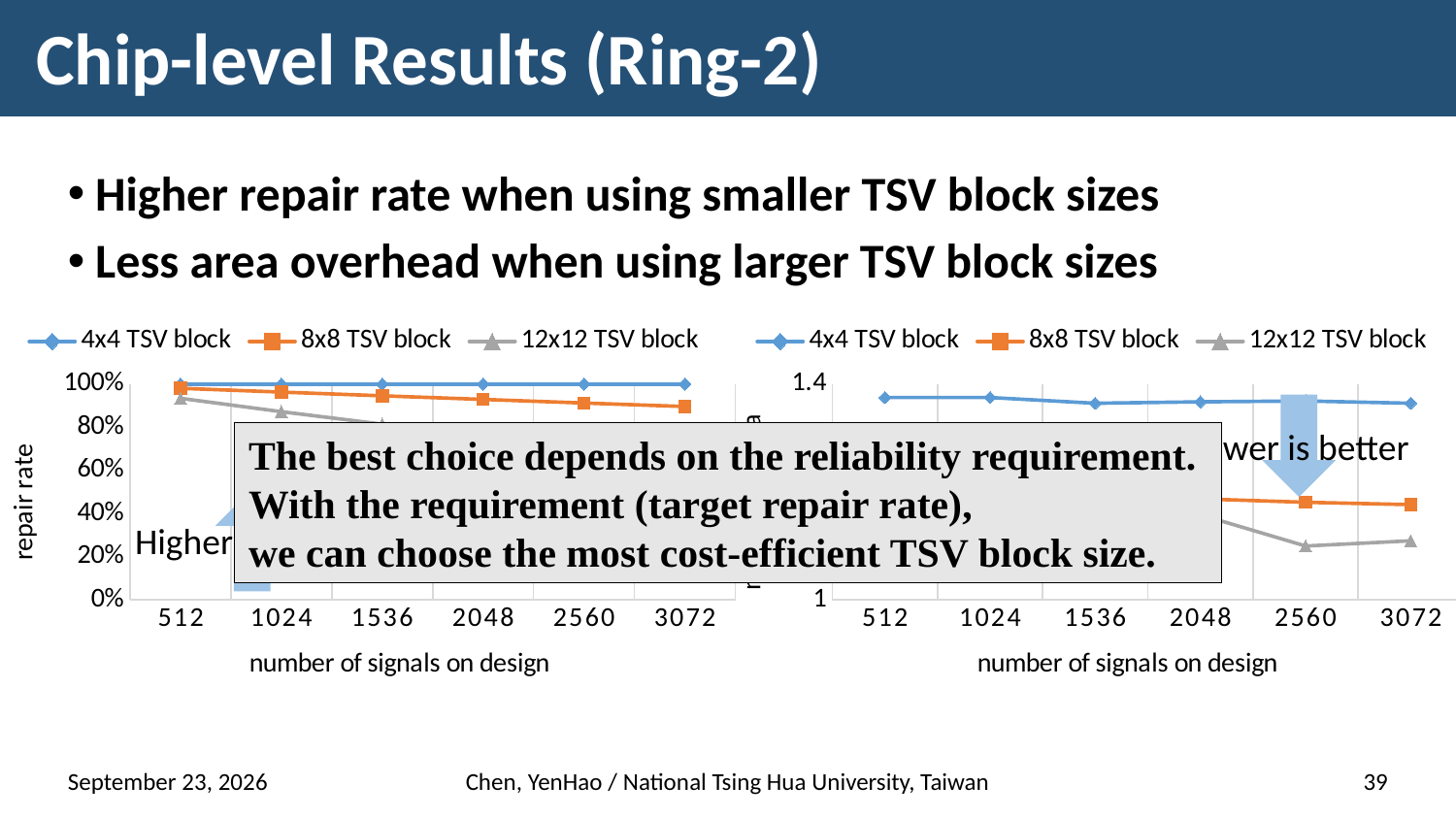
How many points are on the x axis of the left chart (repair rate)? 6 What kind of chart is the left chart (repair rate)? line chart What are the three legend entries of the right chart? 4x4 TSV block, 8x8 TSV block, 12x12 TSV block In the left chart (repair rate), which series has the higher value at 3072 signals, 4x4 TSV block or 8x8 TSV block? 4x4 TSV block In the right chart, which series has the highest values? 4x4 TSV block In the left chart (repair rate), is the value for the 4x4 TSV block at 512 signals greater or less than 80%? greater What is the x-axis label of the left chart (repair rate)? number of signals on design In the left chart (repair rate), which series has the highest repair rate across the design sizes? 4x4 TSV block In the right chart, is the value for the 4x4 TSV block at 512 signals greater or less than 1? greater How many series does the legend of the left chart (repair rate) list? 3 In the left chart (repair rate), does the 8x8 TSV block series rise or fall as the number of signals increases? fall In the left chart (repair rate), is the value for the 12x12 TSV block at 1024 signals greater or less than 100%? less